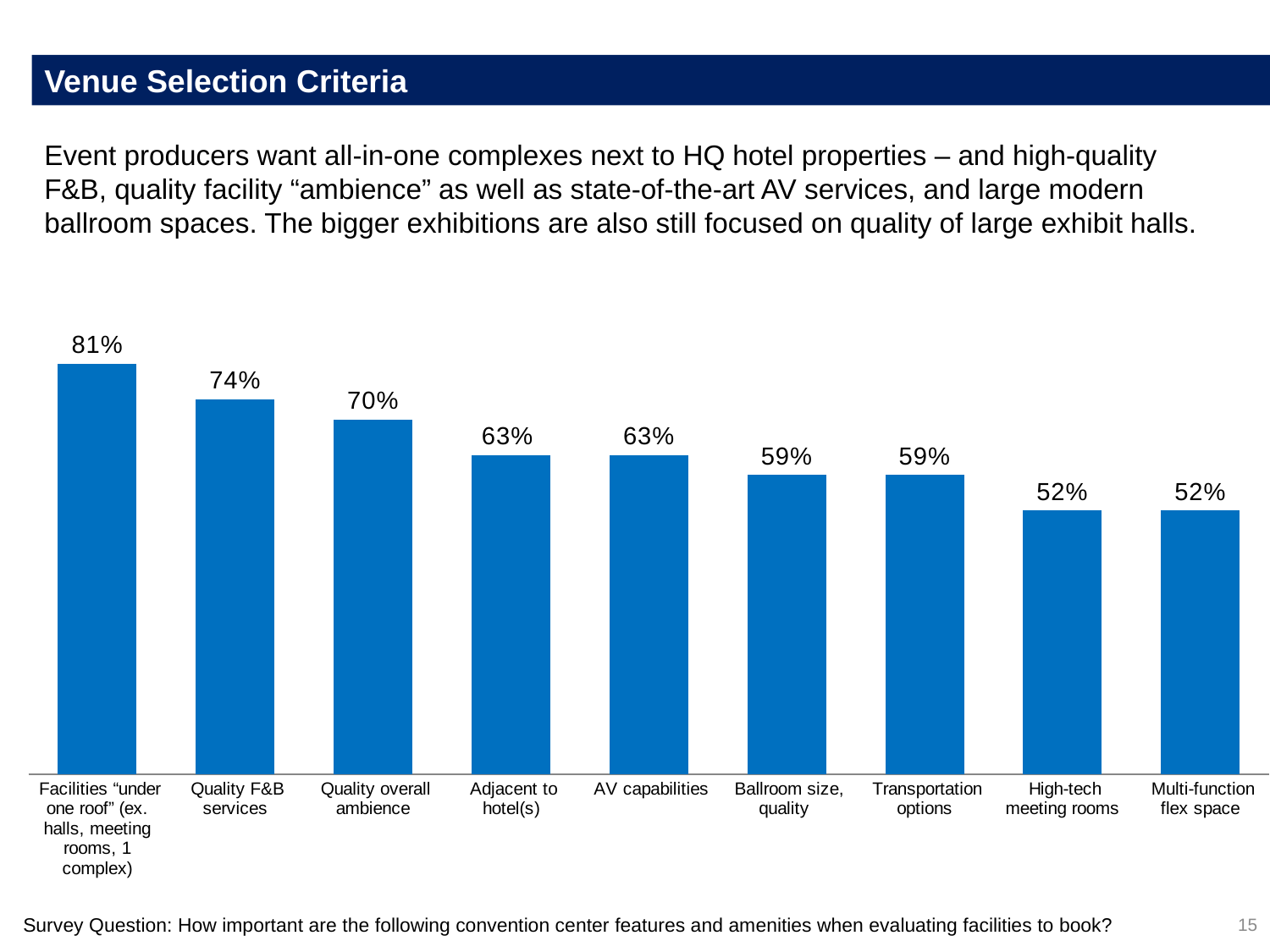
What is the title of the slide containing the chart? Venue Selection Criteria What is the value for Quality F&B services? 74% What is the difference between Facilities "under one roof" and Quality F&B services? 7% What kind of chart is shown on the slide? Bar chart What is the value for Ballroom size, quality? 59% Do the values rise or fall from left to right across the chart? Fall What is the value for the highest bar? 81% Which is larger, Quality F&B services or Transportation options? Quality F&B services How many categories are shown in the chart? 9 What is the value for Adjacent to hotel(s)? 63% Which category has the highest value? Facilities "under one roof" (ex. halls, meeting rooms, 1 complex) What is the difference between Quality overall ambience and High-tech meeting rooms? 18%